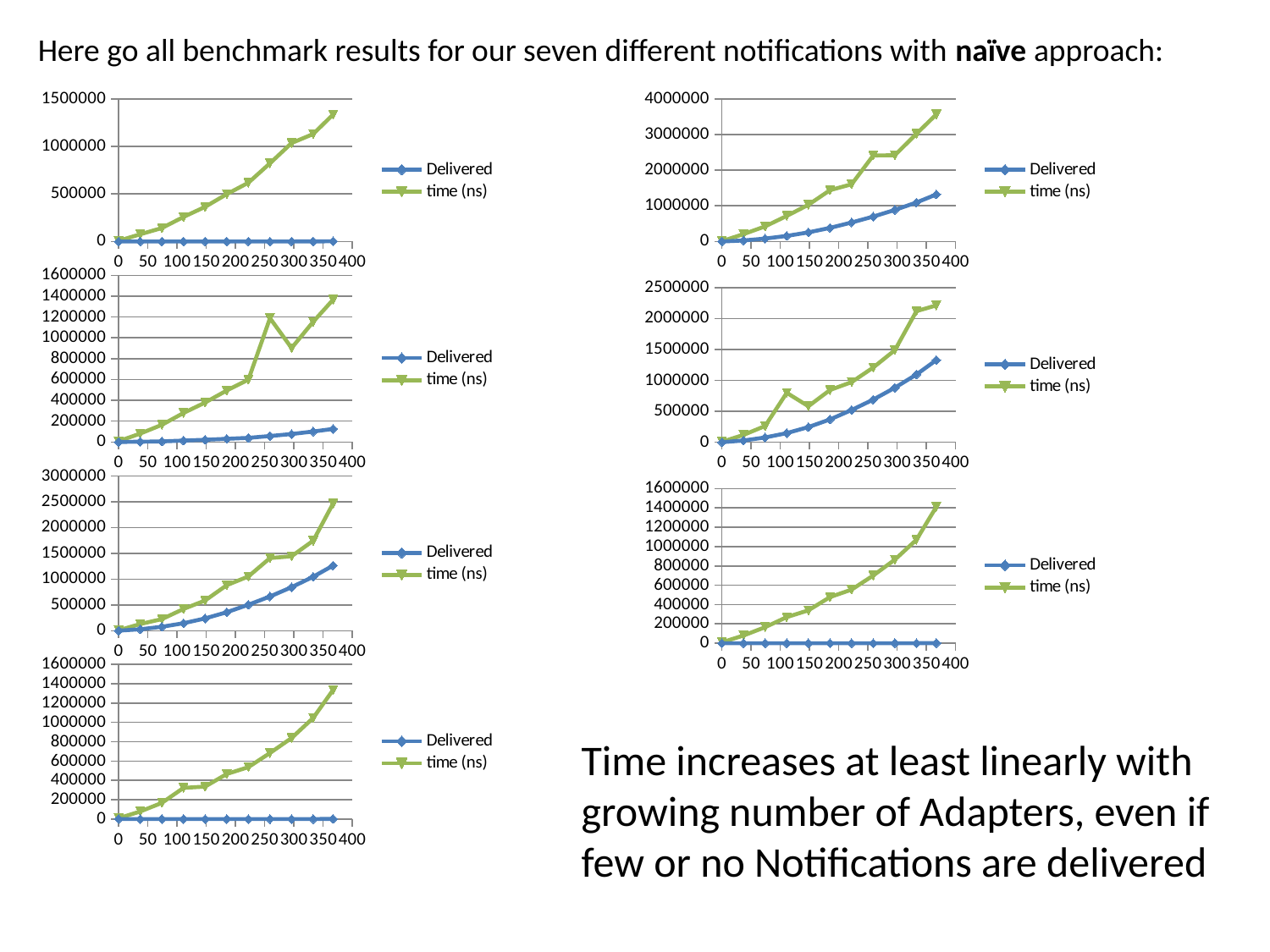
In the top-left chart, does the time (ns) series rise or fall as the x axis increases? rise In the top-right chart, is the value of time (ns) at the rightmost point greater or less than 3000000? greater In the third chart from the top in the left column, is the value of time (ns) at the rightmost point greater or less than 2000000? greater How many series does the legend of the top-left chart list? 2 What are the two legend entries shown for the top-right chart? Delivered and time (ns) In the bottom-right chart, is the value of time (ns) at the rightmost point greater or less than 1000000? greater How many charts are shown on the slide? 7 What kind of chart is the top-left chart on the slide? line chart In the bottom-left chart, does the Delivered series rise, fall, or stay flat along the x axis? stay flat In the top-right chart, which series has the higher value at the rightmost point, Delivered or time (ns)? time (ns)